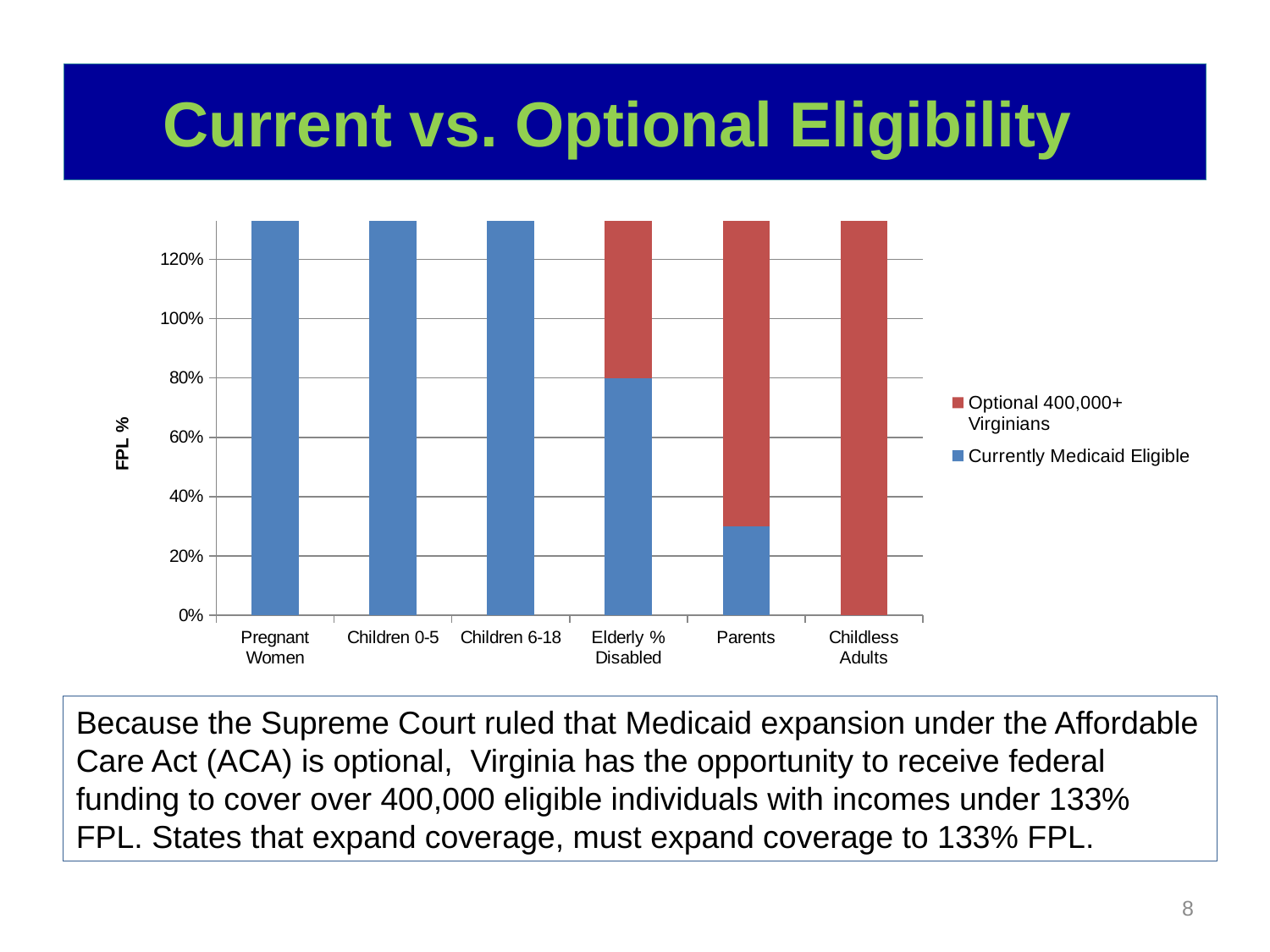
What are the two series named in the chart's legend? Optional 400,000+ Virginians; Currently Medicaid Eligible Is the Currently Medicaid Eligible value for Elderly % Disabled greater or less than 60%? greater What is the title of the chart's vertical axis? FPL % Which is larger: the Currently Medicaid Eligible value for Children 0-5 or for Parents? Children 0-5 How many categories are shown on the x axis of the chart? 6 What kind of chart is shown on the slide? Stacked bar chart Which category has the smallest Currently Medicaid Eligible value? Childless Adults Is the Currently Medicaid Eligible value for Parents greater or less than 40%? less Is the Currently Medicaid Eligible value for Pregnant Women greater or less than 120%? greater Which is larger: the Currently Medicaid Eligible value for Elderly % Disabled or for Parents? Elderly % Disabled How many series does the chart's legend list? 2